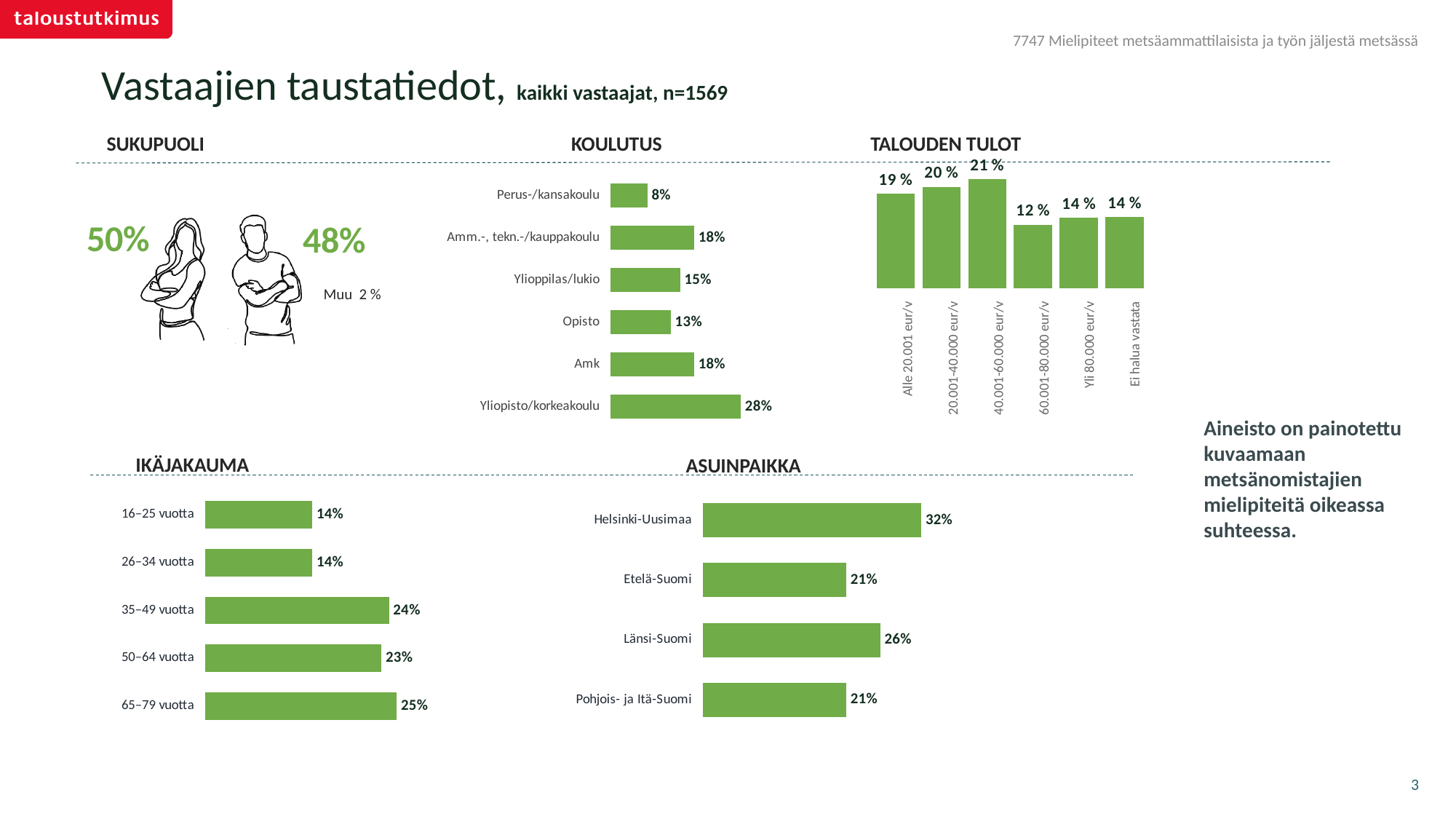
In the ASUINPAIKKA chart, which category has the highest value? Helsinki-Uusimaa In the TALOUDEN TULOT chart, which category has the highest value? 40.001-60.000 eur/v How many categories does the KOULUTUS chart show? 6 In the KOULUTUS chart, what is the value for Yliopisto/korkeakoulu? 28% In the ASUINPAIKKA chart, what is the difference between Helsinki-Uusimaa and Länsi-Suomi? 6% In the IKÄJAKAUMA chart, what is the value for 65–79 vuotta? 25% In the KOULUTUS chart, which category has the lowest value? Perus-/kansakoulu What kind of chart is the TALOUDEN TULOT chart? bar chart How many categories does the ASUINPAIKKA chart show? 4 In the IKÄJAKAUMA chart, which is larger, 35–49 vuotta or 50–64 vuotta? 35–49 vuotta In the TALOUDEN TULOT chart, what is the value for 60.001-80.000 eur/v? 12 % In the KOULUTUS chart, what is the difference between Yliopisto/korkeakoulu and Opisto? 15%